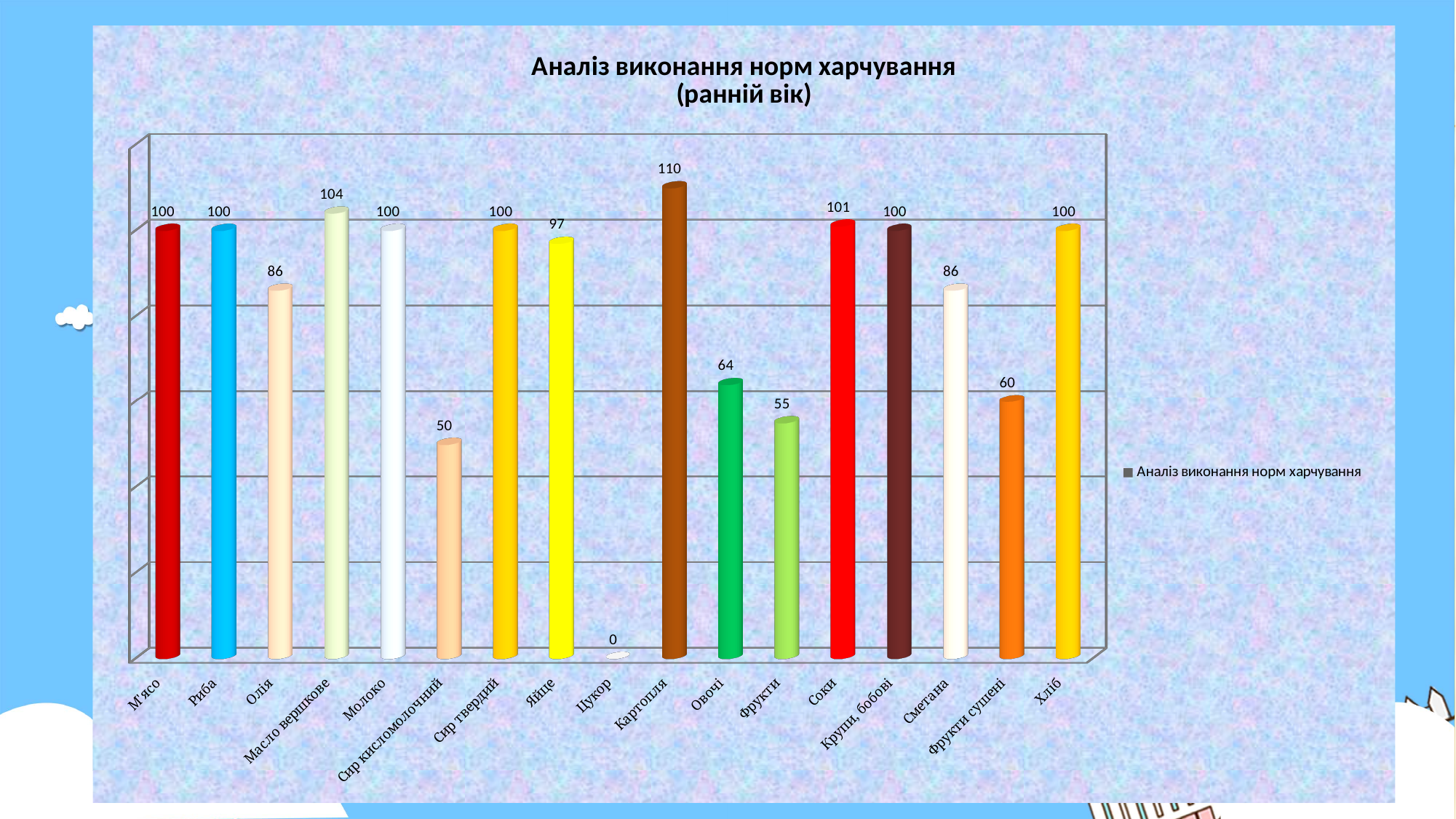
What is the value for Картопля? 110 Which category has the lowest value? Цукор Which category has the highest value? Картопля How many series does the legend list? 1 What kind of chart is shown on the slide? Bar chart What is the value for Фрукти сушені? 60 What is the difference between the values for Картопля and Фрукти? 55 What is the value for Сир кисломолочний? 50 What is the difference between the values for Масло вершкове and Олія? 18 How many categories are shown on the x axis? 17 Which is larger, the value for Овочі or the value for Фрукти? Овочі Which is larger, the value for Сметана or the value for Фрукти сушені? Сметана